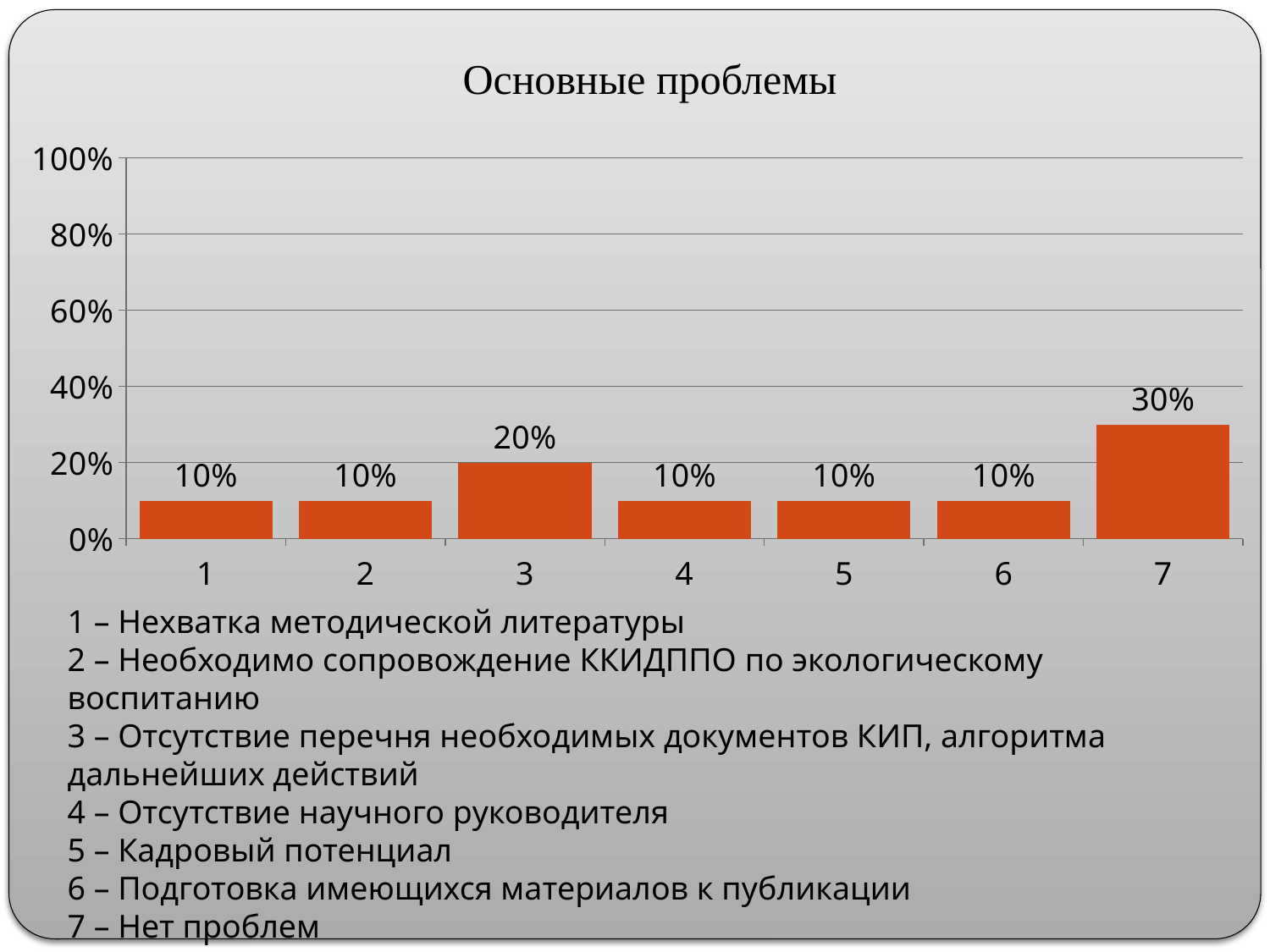
What is the difference between the values for category 7 and category 5? 20% Which category has the highest value? 7 What is the value for category 7? 30% What is the title of the chart? Основные проблемы Is the value for category 7 greater or less than 40%? less How many categories have a value of 10%? 5 What kind of chart is shown on the slide? bar chart What is the value for category 3? 20% What is the difference between the values for category 7 and category 3? 10% What is the value for category 1? 10% Which is larger, the value for category 3 or the value for category 4? category 3 How many categories are shown on the x axis? 7